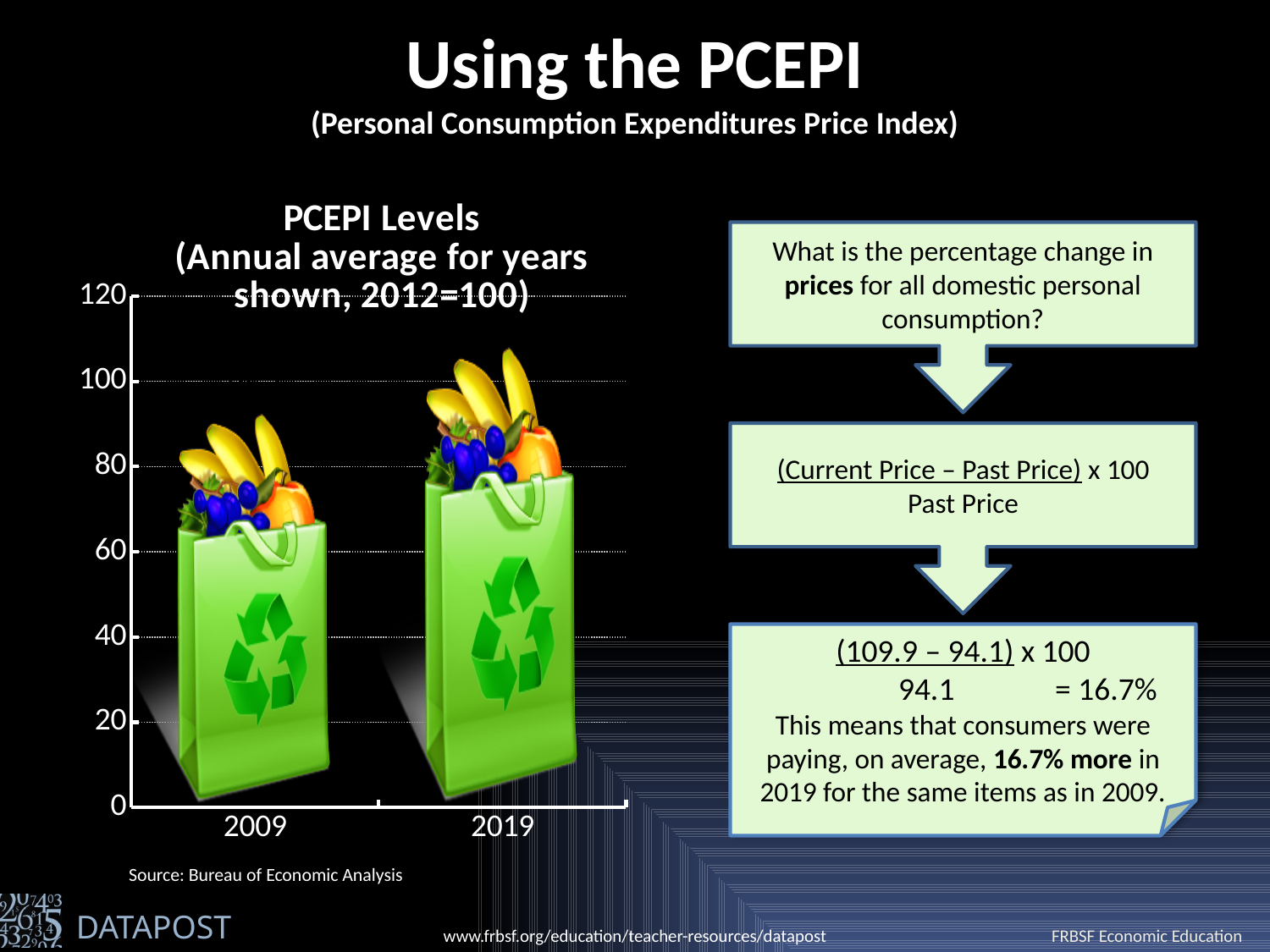
Is the PCEPI level for 2009 greater or less than 80? greater What is the source of the data in the PCEPI Levels chart? Bureau of Economic Analysis Which year has the higher PCEPI level in the chart? 2019 Is the PCEPI level for 2009 greater or less than 100? less Which year has the lower PCEPI level in the chart? 2009 What kind of chart is shown on the slide? bar chart Does the PCEPI level rise or fall from 2009 to 2019? rise According to the slide, what is the PCEPI level for 2009? 94.1 Is the PCEPI level for 2009 larger or smaller than the level for 2019? smaller Is the PCEPI level for 2019 greater or less than 100? greater How many years are shown on the x axis of the PCEPI Levels chart? 2 According to the slide, what is the PCEPI level for 2019? 109.9